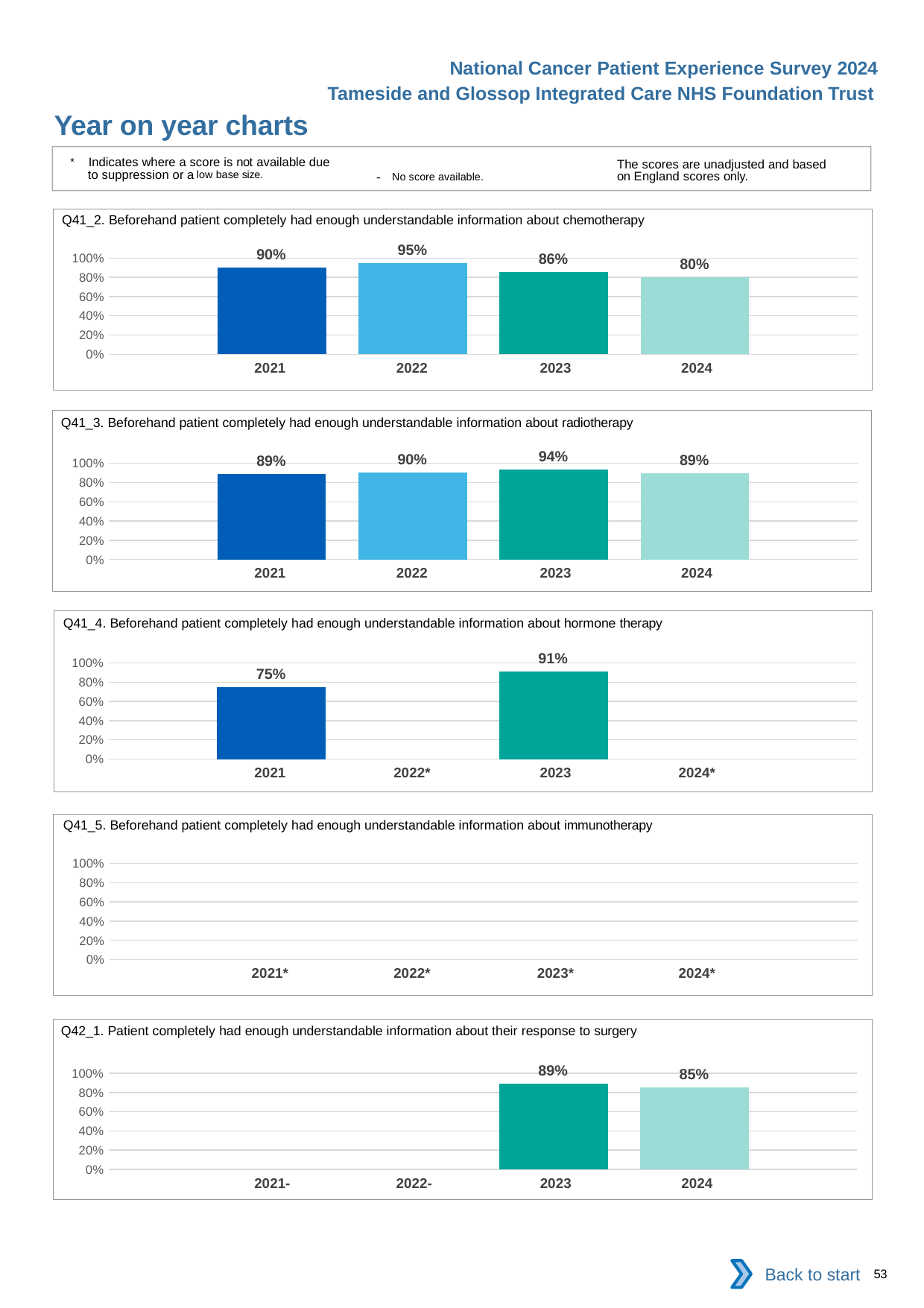
In the Q41_4 chart (hormone therapy), what is the difference between the 2023 and 2021 values? 16% What kind of chart is the Q41_2 chart (chemotherapy)? bar chart In the Q41_5 chart (immunotherapy), how many bars are plotted? 0 In the Q42_1 chart (response to surgery), do the values rise or fall from 2023 to 2024? fall In the Q41_2 chart (chemotherapy), what is the difference between the 2022 and 2024 values? 15% In the Q41_4 chart (hormone therapy), which is larger, the 2021 value or the 2023 value? 2023 In the Q41_2 chart (chemotherapy), which year has the lowest value? 2024 In the Q41_3 chart (radiotherapy), what is the value for 2021? 89% In the Q41_4 chart (hormone therapy), what is the value for 2023? 91% In the Q42_1 chart (response to surgery), what is the value for 2024? 85% In the Q41_3 chart (radiotherapy), which year has the highest value? 2023 In the Q41_2 chart (chemotherapy), what is the value for 2022? 95%